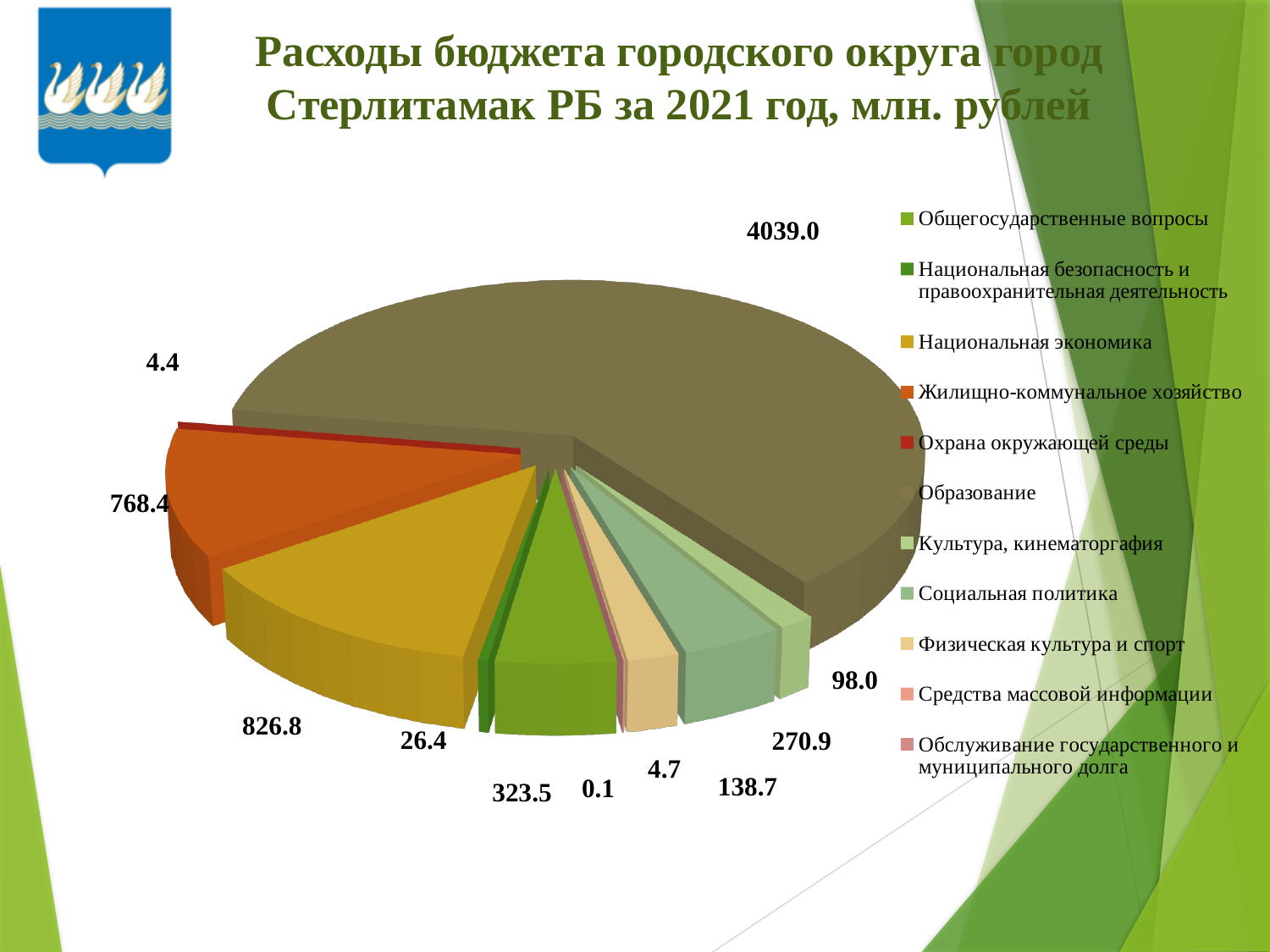
What is the value for Жилищно-коммунальное хозяйство? 768.4 Which is larger: Социальная политика or Физическая культура и спорт? Социальная политика What is the title of the chart? Расходы бюджета городского округа город Стерлитамак РБ за 2021 год, млн. рублей What is the value for Образование? 4039.0 Which category has the smallest value? Обслуживание государственного и муниципального долга What is the value for Культура, кинематоргафия? 98.0 How many categories does the legend list? 11 What type of chart is shown on the slide? Pie chart What is the difference between the values for Национальная экономика and Жилищно-коммунальное хозяйство? 58.4 What is the difference between the values for Общегосударственные вопросы and Социальная политика? 52.6 Which category has the largest slice of the pie? Образование What is the value for Национальная экономика? 826.8